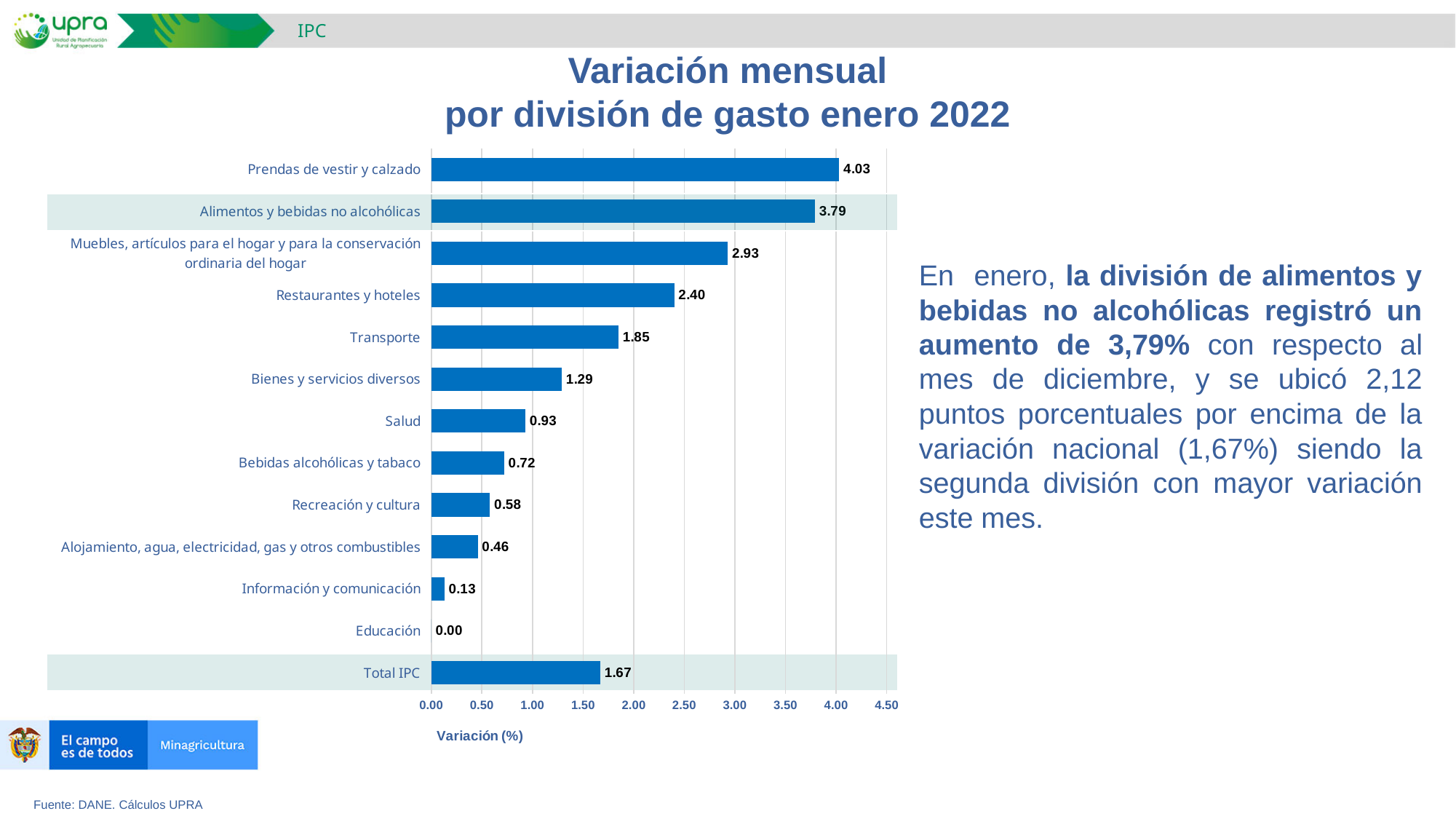
What is the title of the chart? Variación mensual por división de gasto enero 2022 What is the label of the horizontal axis? Variación (%) Which is larger, the value for Salud or the value for Bebidas alcohólicas y tabaco? Salud Is the value for Restaurantes y hoteles greater or less than 2.00? greater What is the value for Total IPC? 1.67 Which division has the highest monthly variation? Prendas de vestir y calzado What kind of chart is shown on the slide? Bar chart What is the value for Alimentos y bebidas no alcohólicas? 3.79 Which division has the lowest monthly variation? Educación What is the value for Transporte? 1.85 How many categories are shown in the chart, including Total IPC? 13 What is the difference between the values for Prendas de vestir y calzado and Alimentos y bebidas no alcohólicas? 0.24